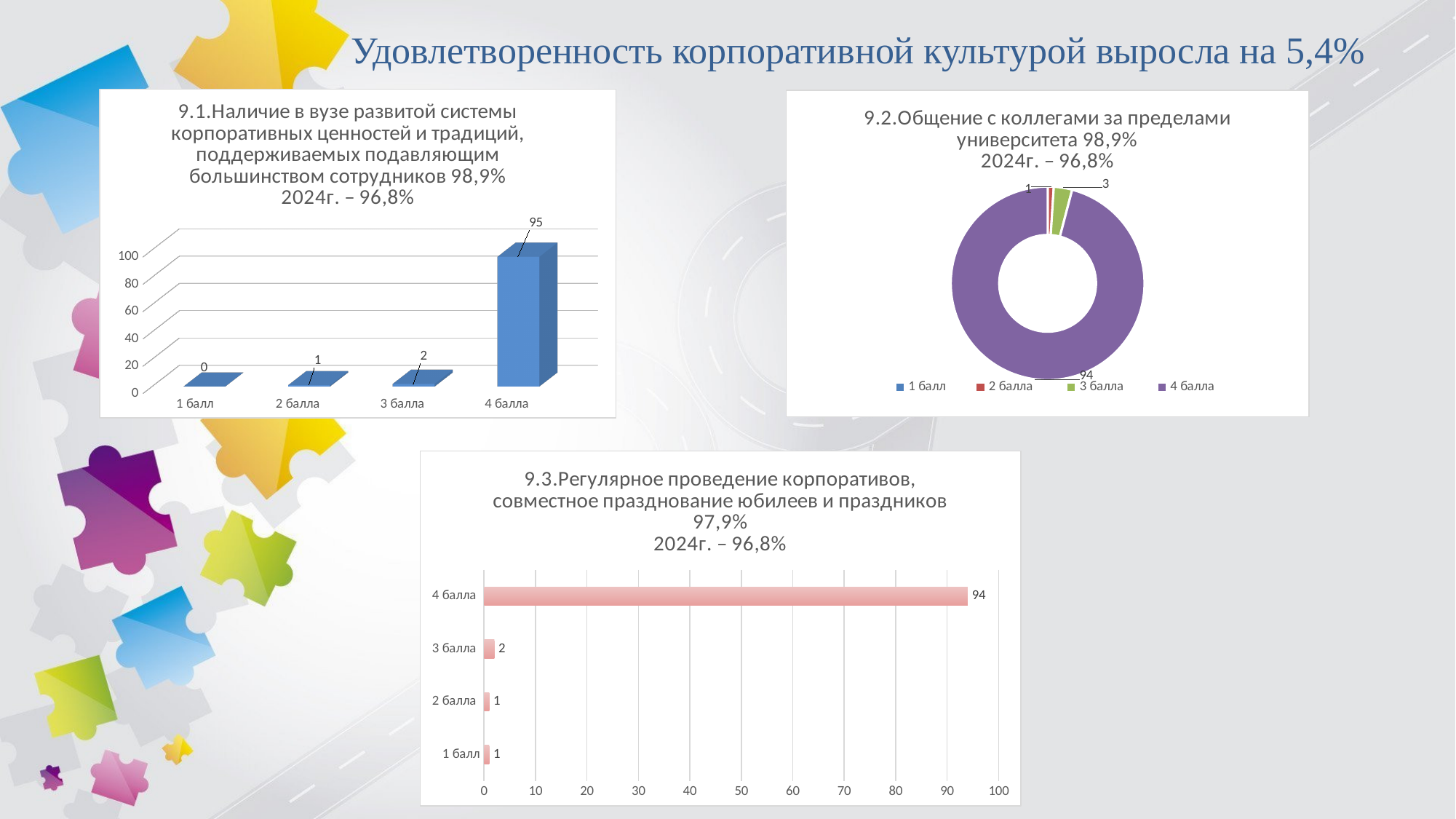
In the chart 9.3 (bottom), which is larger, the value for 3 балла or the value for 2 балла? 3 балла What kind of chart is chart 9.2 (top right)? Doughnut chart What kind of chart is chart 9.1 (top left)? Bar chart In the chart 9.2 (top right), what is the value for 3 балла? 3 In the chart 9.1 (top left), what is the difference between the values for 4 балла and 3 балла? 93 In the chart 9.2 (top right), what is the value for 4 балла? 94 In the chart 9.1 (top left), which category has the lowest value? 1 балл How many categories are shown in chart 9.3 (bottom)? 4 In the chart 9.1 (top left), what is the value for 3 балла? 2 In the chart 9.1 (top left), what is the value for 4 балла? 95 How many entries does the legend of chart 9.2 (top right) list? 4 In the chart 9.3 (bottom), what is the value for 4 балла? 94